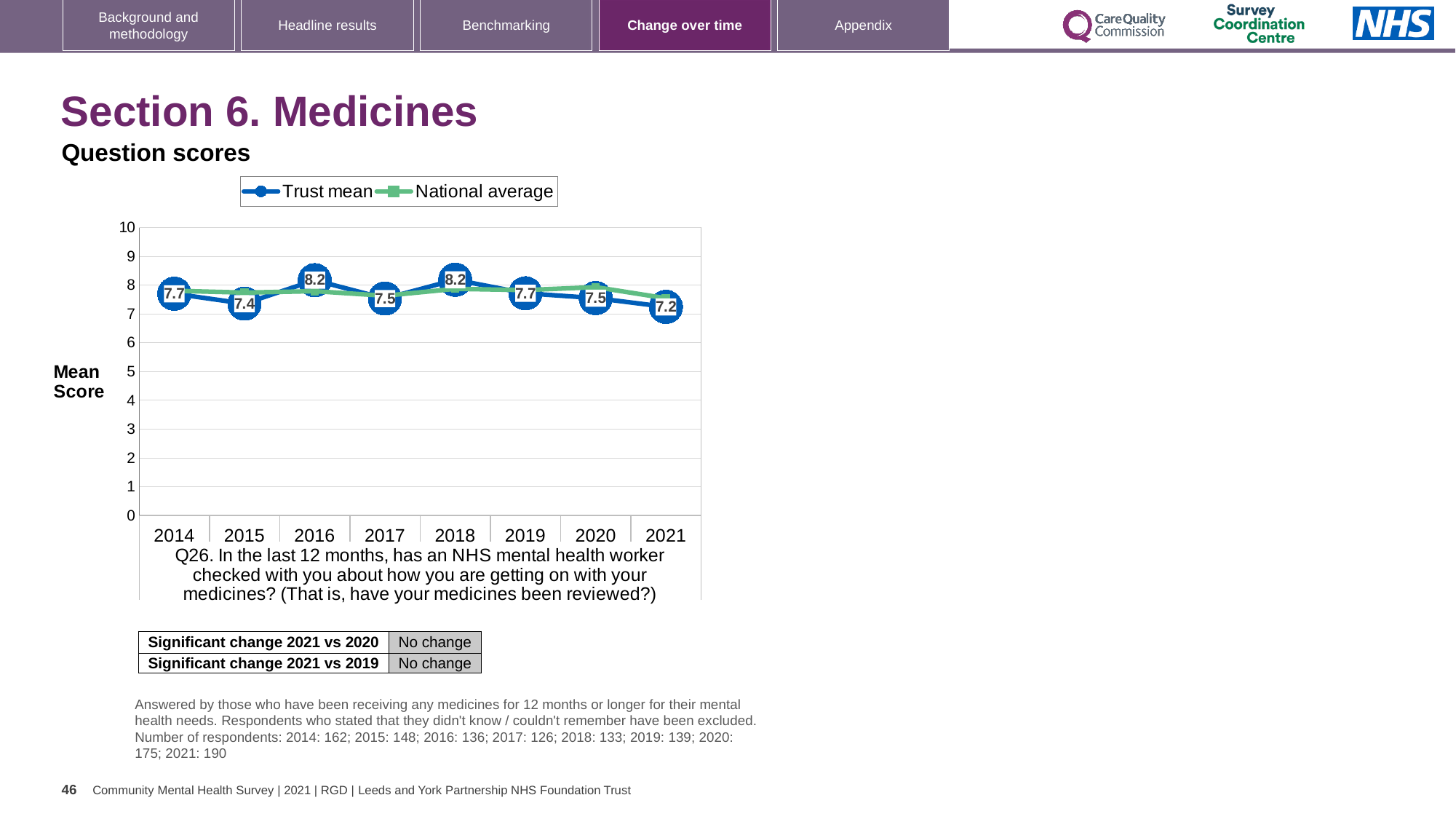
What is the Trust mean score for 2016? 8.2 Is the National average value for 2021 greater or less than 7? greater How many years are shown on the x axis? 8 How many series does the legend list? 2 Does the Trust mean score rise or fall from 2019 to 2021? Fall What is the highest Trust mean score shown on the chart? 8.2 What is the difference between the Trust mean score in 2016 and in 2021? 1.0 What is the Trust mean score for 2021? 7.2 In which year is the Trust mean score lowest? 2021 What is the Trust mean score for 2015? 7.4 Which year has the larger Trust mean score, 2015 or 2016? 2016 What kind of chart is shown on the slide? Line chart